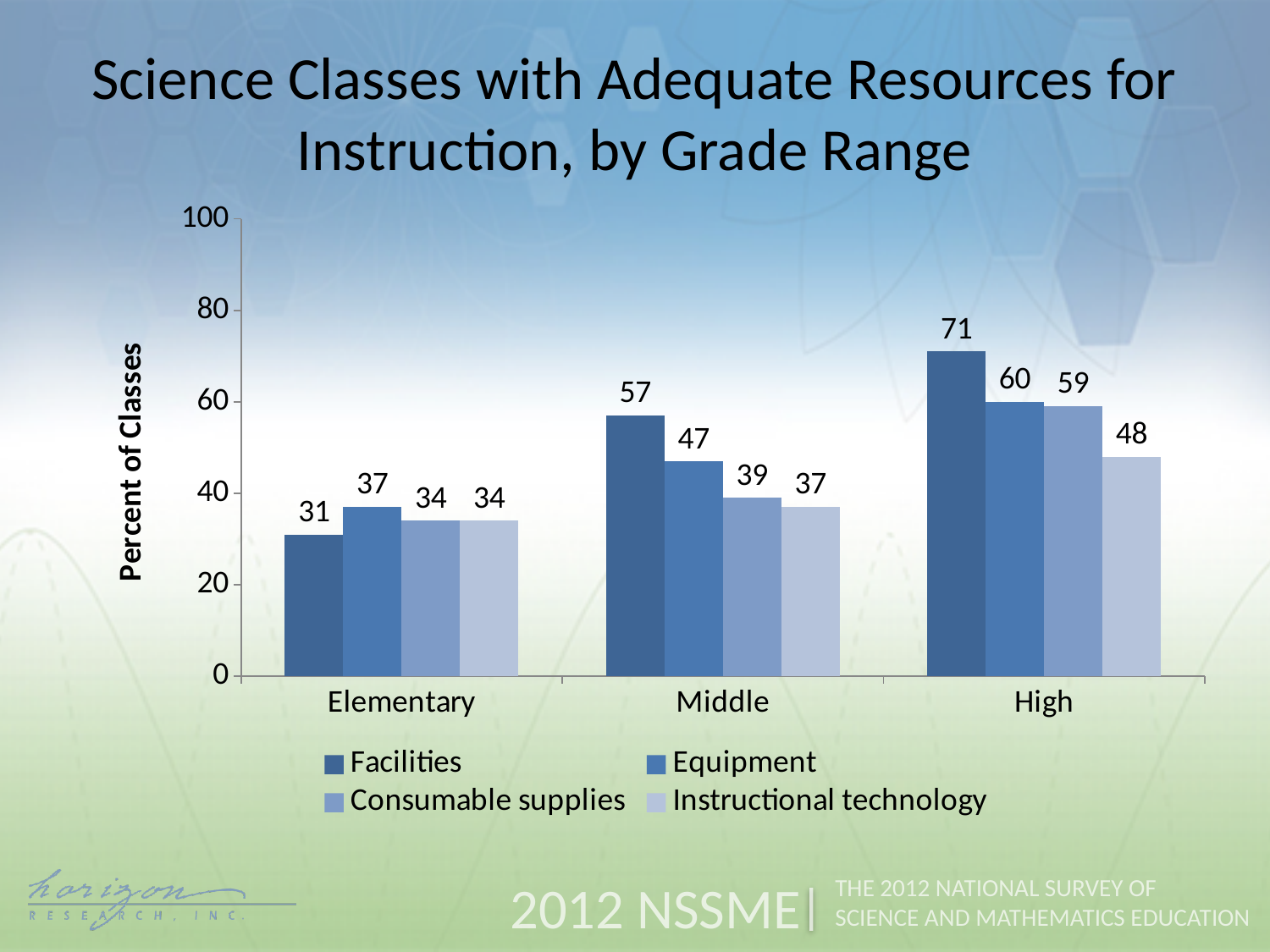
What kind of chart is shown on the slide? Bar chart Which is larger: Equipment for Middle or Instructional technology for High? Instructional technology for High How many series does the legend list? 4 How many grade ranges are shown on the x axis? 3 What is the value for Facilities in the High grade range? 71 Which grade range has the lowest value for Consumable supplies? Elementary What is the value for Instructional technology in the Middle grade range? 37 What is the value for Equipment in the Elementary grade range? 37 What is the difference between the Facilities values for High and Middle? 14 Do the Facilities values rise or fall from Elementary to High? Rise Is the value for Facilities in the Middle grade range greater or less than 40? greater Which grade range has the highest value for Facilities? High